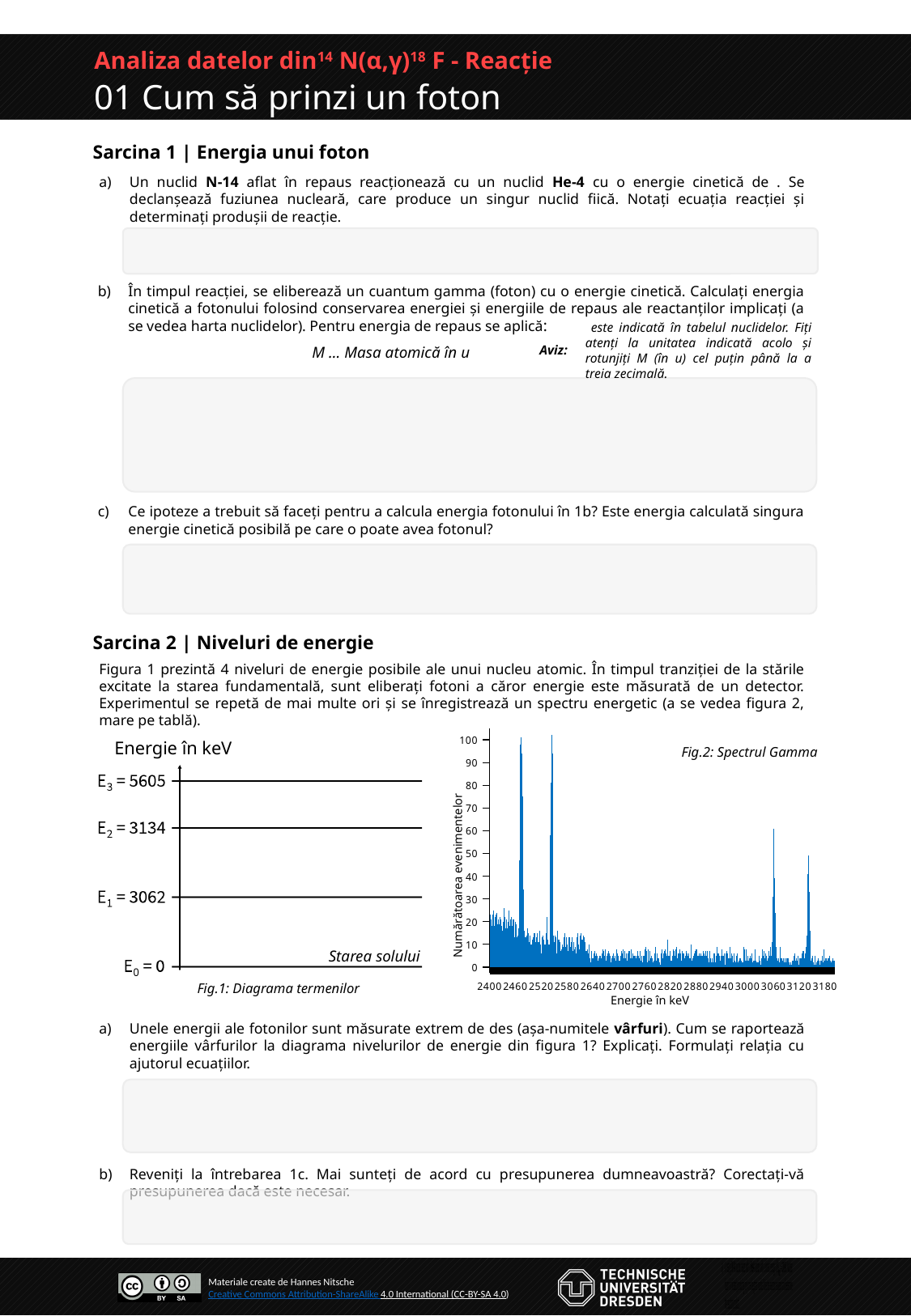
In Fig.1: Diagrama termenilor, how many energy levels are shown? 4 In Fig.2: Spectrul Gamma, what is the highest value shown on the y axis? 100 In Fig.2: Spectrul Gamma, what is the label of the x axis? Energie în keV In Fig.2: Spectrul Gamma, is the count at the peak near 3060 keV greater or less than 40? greater In Fig.2: Spectrul Gamma, is the count at the tallest peak near 2470 keV greater or less than 80? greater In Fig.1: Diagrama termenilor, what is the energy of level E3? 5605 In Fig.2: Spectrul Gamma, what is the label of the y axis? Numărătoarea evenimentelor In Fig.1: Diagrama termenilor, what is the difference in energy between E2 and E1? 72 In Fig.2: Spectrul Gamma, which is taller: the peak near 2470 keV or the peak near 3060 keV? the peak near 2470 keV In Fig.1: Diagrama termenilor, what is the energy of level E1? 3062 In Fig.2: Spectrul Gamma, is the background count level near 2700 keV greater or less than 30? less